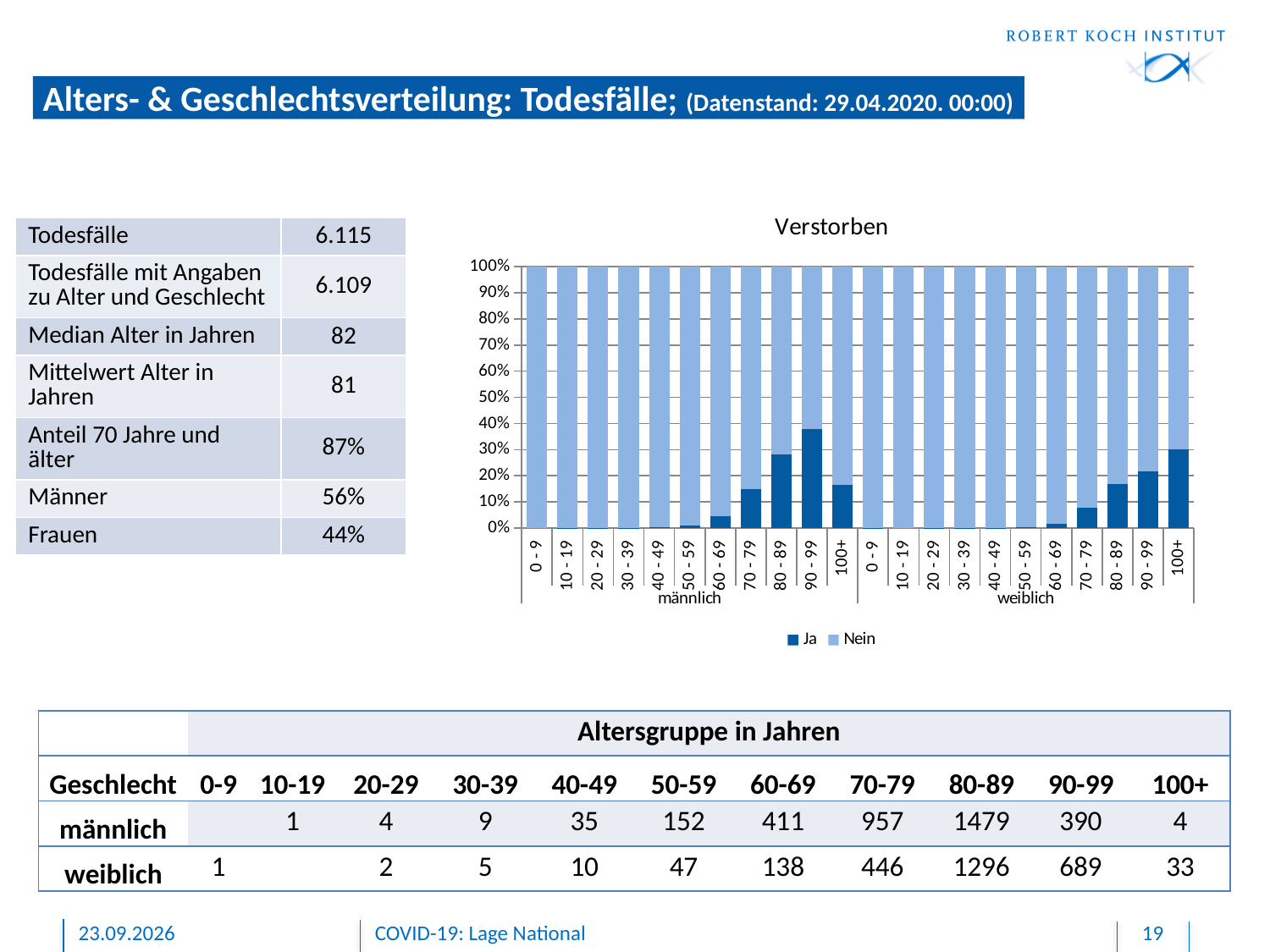
In the 'Verstorben' chart, is the 'Ja' share for männlich 90 - 99 greater or less than 30%? greater How many bars are plotted in the 'Verstorben' chart? 22 In the 'Verstorben' chart, is the 'Ja' share for männlich 80 - 89 greater or less than 20%? greater In the 'Verstorben' chart, which has the larger 'Ja' share: männlich 100+ or weiblich 100+? weiblich 100+ In the 'Verstorben' chart, is the 'Ja' share for weiblich 100+ greater or less than 20%? greater What is the title of the chart on the slide? Verstorben What are the two legend entries of the 'Verstorben' chart? Ja, Nein What kind of chart is the 'Verstorben' chart? stacked bar chart In the 'Verstorben' chart, which bar has the largest 'Ja' share? männlich 90 - 99 How many series does the legend of the 'Verstorben' chart list? 2 In the 'Verstorben' chart, which has the larger 'Ja' share: männlich 90 - 99 or weiblich 90 - 99? männlich 90 - 99